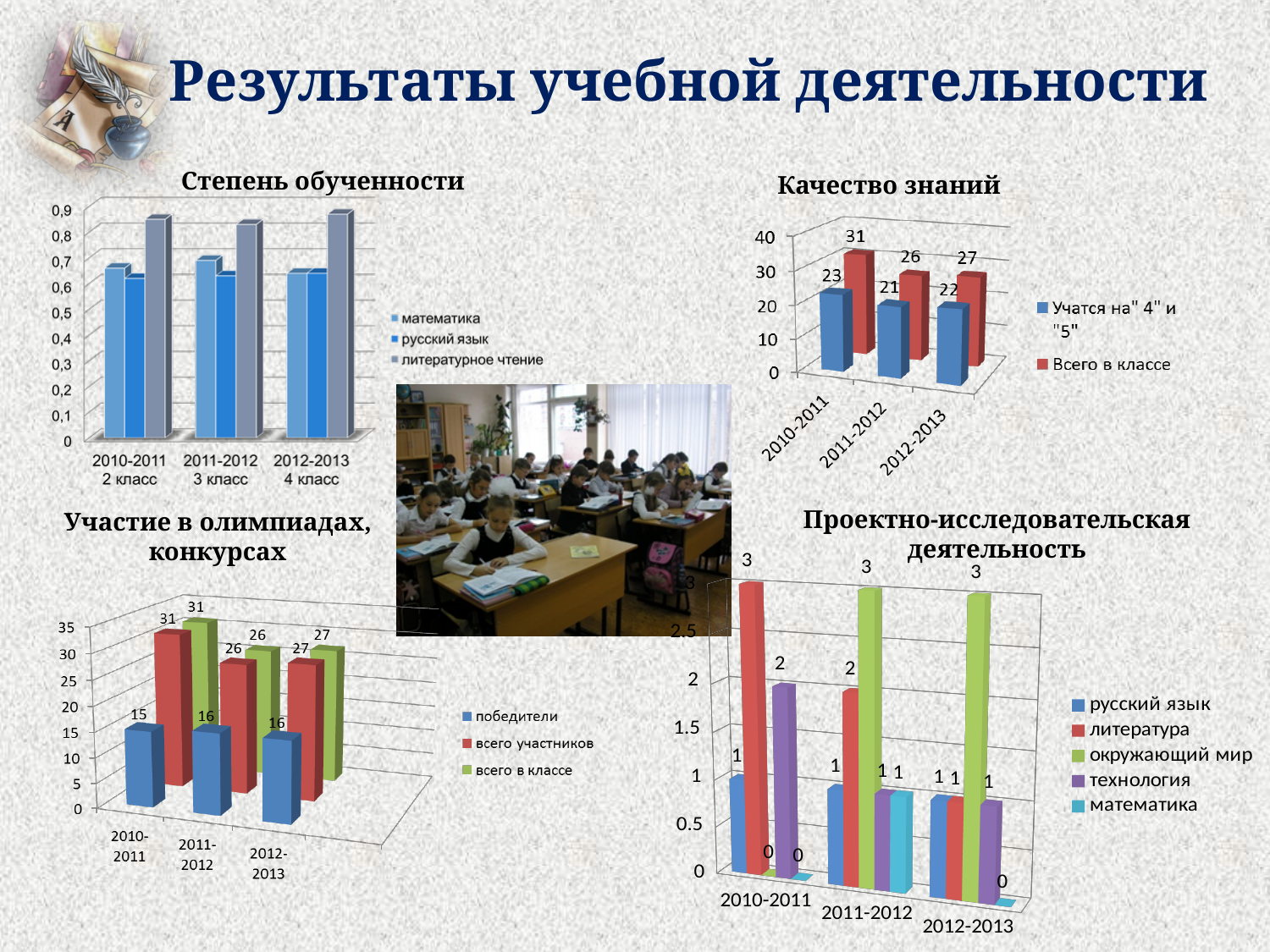
In the 'Проектно-исследовательская деятельность' chart, what is the value of 'литература' for 2010-2011? 3 In the 'Участие в олимпиадах, конкурсах' chart, how many categories are shown on the x axis? 3 In the 'Степень обученности' chart, is the value for 'литературное чтение' in 2012-2013 4 класс greater or less than 0.8? greater What kind of chart is 'Степень обученности'? bar chart In the 'Проектно-исследовательская деятельность' chart, what is the value of 'технология' for 2010-2011? 2 In the 'Участие в олимпиадах, конкурсах' chart, which year has the highest value for 'всего участников'? 2010-2011 In the 'Участие в олимпиадах, конкурсах' chart, what is the value of 'победители' for 2010-2011? 15 In the 'Качество знаний' chart, what is the value of 'Учатся на "4" и "5"' for 2012-2013? 22 In the 'Качество знаний' chart, what is the difference between 'Всего в классе' and 'Учатся на "4" и "5"' for 2011-2012? 5 In the 'Качество знаний' chart, what is the value of 'Всего в классе' for 2010-2011? 31 In the 'Качество знаний' chart, how many series does the legend list? 2 In the 'Проектно-исследовательская деятельность' chart, how many series does the legend list? 5